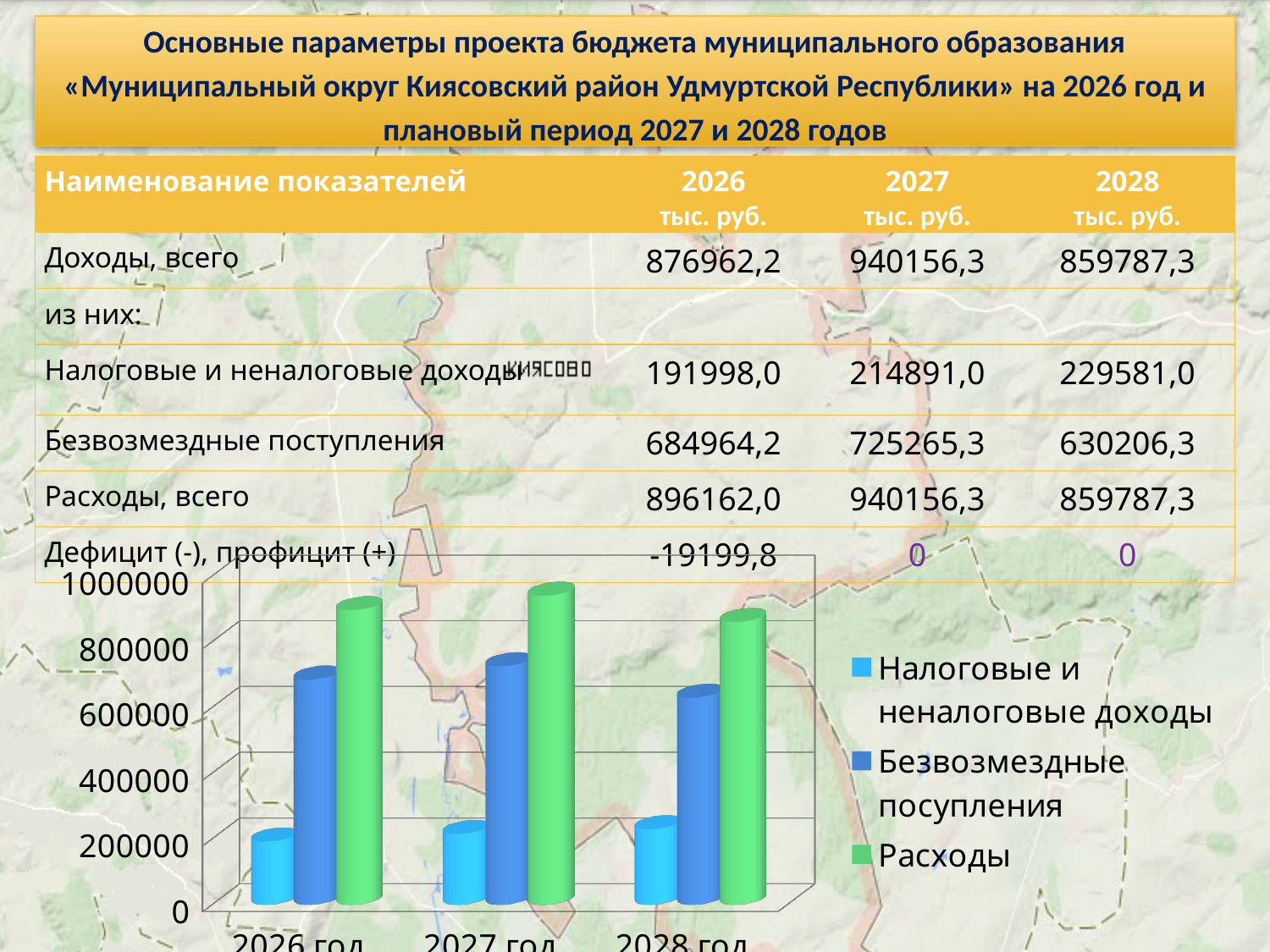
In which year is the bar for Расходы the tallest? 2027 год Do the bars for Налоговые и неналоговые доходы rise or fall from 2026 год to 2028 год? rise Is the value for Безвозмездные посупления in 2027 год greater or less than 600000? greater Which is larger on the chart: Безвозмездные посупления in 2027 год or in 2028 год? 2027 год How many year categories are shown on the chart's x axis? 3 In which year is the bar for Налоговые и неналоговые доходы the shortest? 2026 год Is the value for Налоговые и неналоговые доходы in 2026 год greater or less than 400000? less Which is larger on the chart: Расходы in 2027 год or Расходы in 2028 год? 2027 год What colour are the bars for Расходы in the chart? green What kind of chart is shown at the bottom of the slide? bar chart Is the value for Расходы in 2027 год greater or less than 800000? greater How many series does the chart's legend list? 3